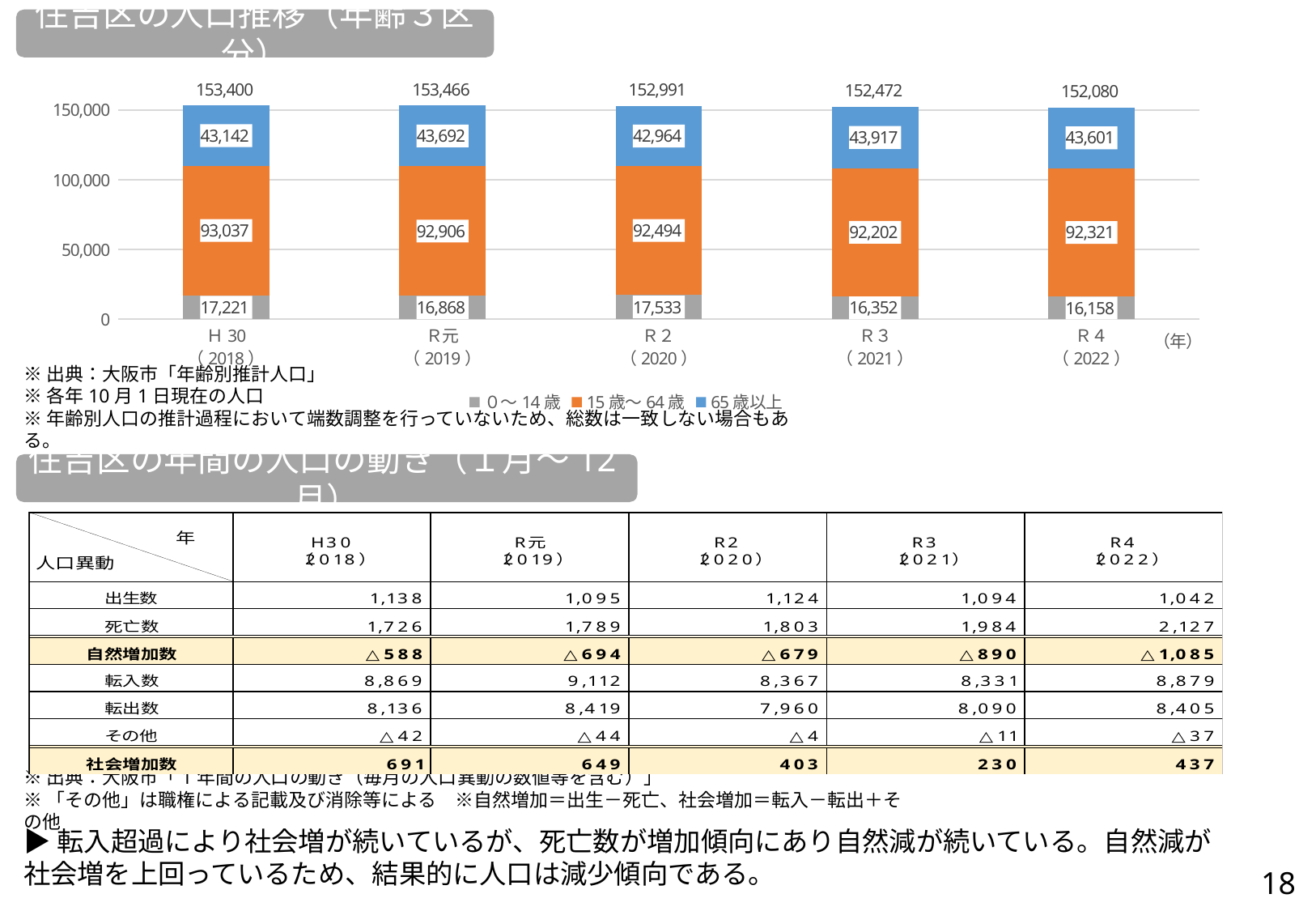
What is the difference between the 15歳～64歳 value in H30 (2018) and in R4 (2022)? 716 What kind of chart is shown on the slide? Stacked bar chart What is the value for the 15歳～64歳 series in R2 (2020)? 92,494 Does the total population rise or fall from R元 (2019) to R4 (2022)? Falls Which is larger, the 65歳以上 value in R元 (2019) or in R3 (2021)? R3 (2021) In which year is the 65歳以上 value the lowest? R2 (2020) In which year is the 0～14歳 value the highest? R2 (2020) What is the total population shown above the stacked bar for R3 (2021)? 152,472 What is the value for the 65歳以上 series in H30 (2018)? 43,142 What is the value for the 0～14歳 series in R4 (2022)? 16,158 How many series does the chart's legend list? 3 How many years are shown on the x axis of the chart? 5